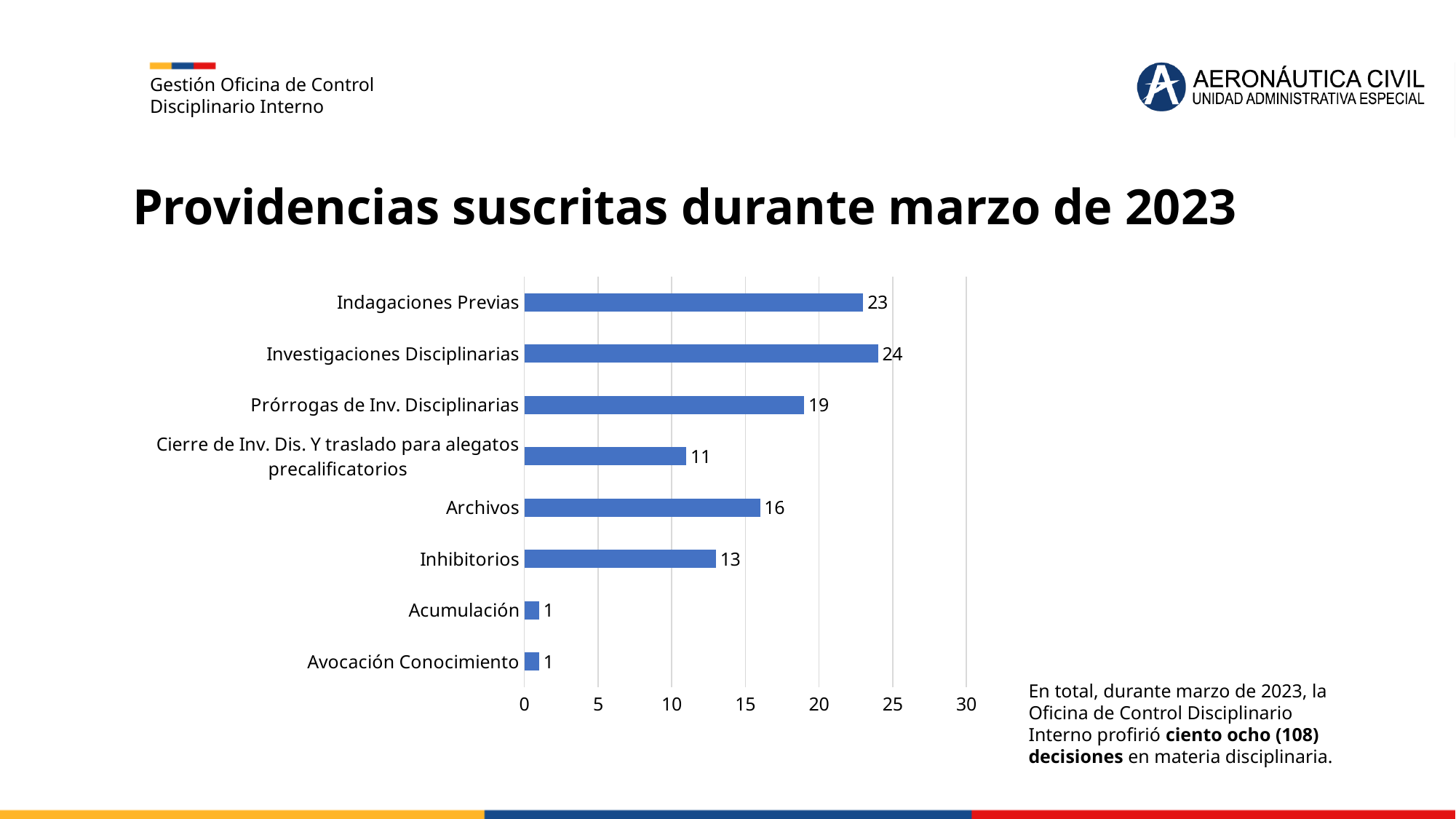
How many categories are shown in the chart? 8 What is the title of the slide containing the chart? Providencias suscritas durante marzo de 2023 What is the value for Archivos? 16 What is the value for Prórrogas de Inv. Disciplinarias? 19 What kind of chart is shown? Bar chart What is the value for Indagaciones Previas? 23 Is the value for Prórrogas de Inv. Disciplinarias greater or less than 15? greater What is the value for Inhibitorios? 13 Which category has the highest value? Investigaciones Disciplinarias What is the difference between Investigaciones Disciplinarias and Cierre de Inv. Dis. Y traslado para alegatos precalificatorios? 13 What is the value for Acumulación? 1 Which is larger, Archivos or Inhibitorios? Archivos